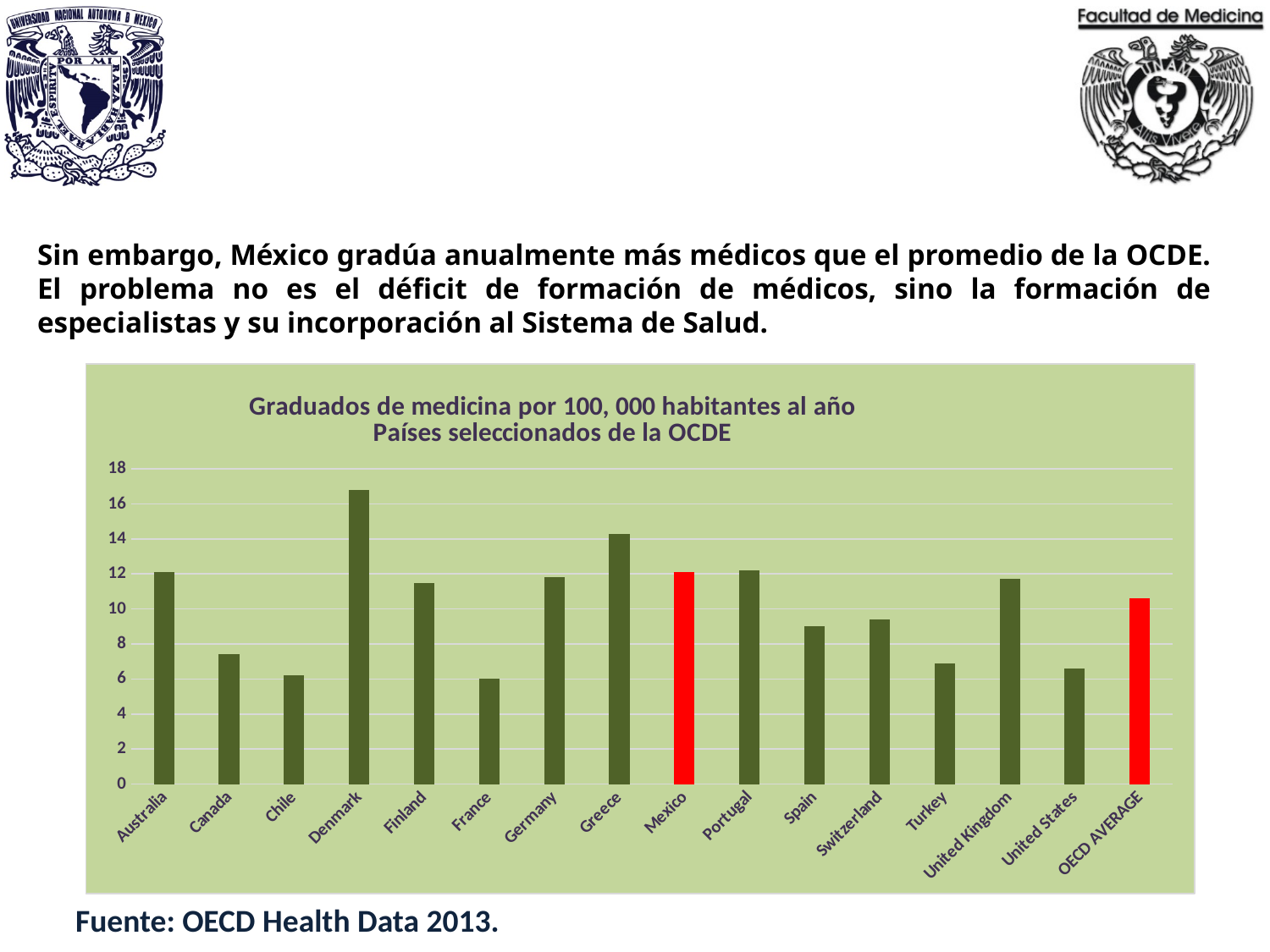
How many bars (countries plus the OECD average) are plotted in the chart? 16 Is the value for Canada greater or less than 8? less Is the value for Mexico greater or less than 10? greater Is the value for Denmark greater or less than 16? greater What is the first line of the chart's title? Graduados de medicina por 100, 000 habitantes al año Which is larger, the value for Mexico or the value for OECD AVERAGE? Mexico Which category has the highest value in the chart? Denmark What kind of chart is shown on the slide? bar chart Which is larger, the value for Greece or the value for Portugal? Greece Which two bars in the chart are coloured red? Mexico and OECD AVERAGE